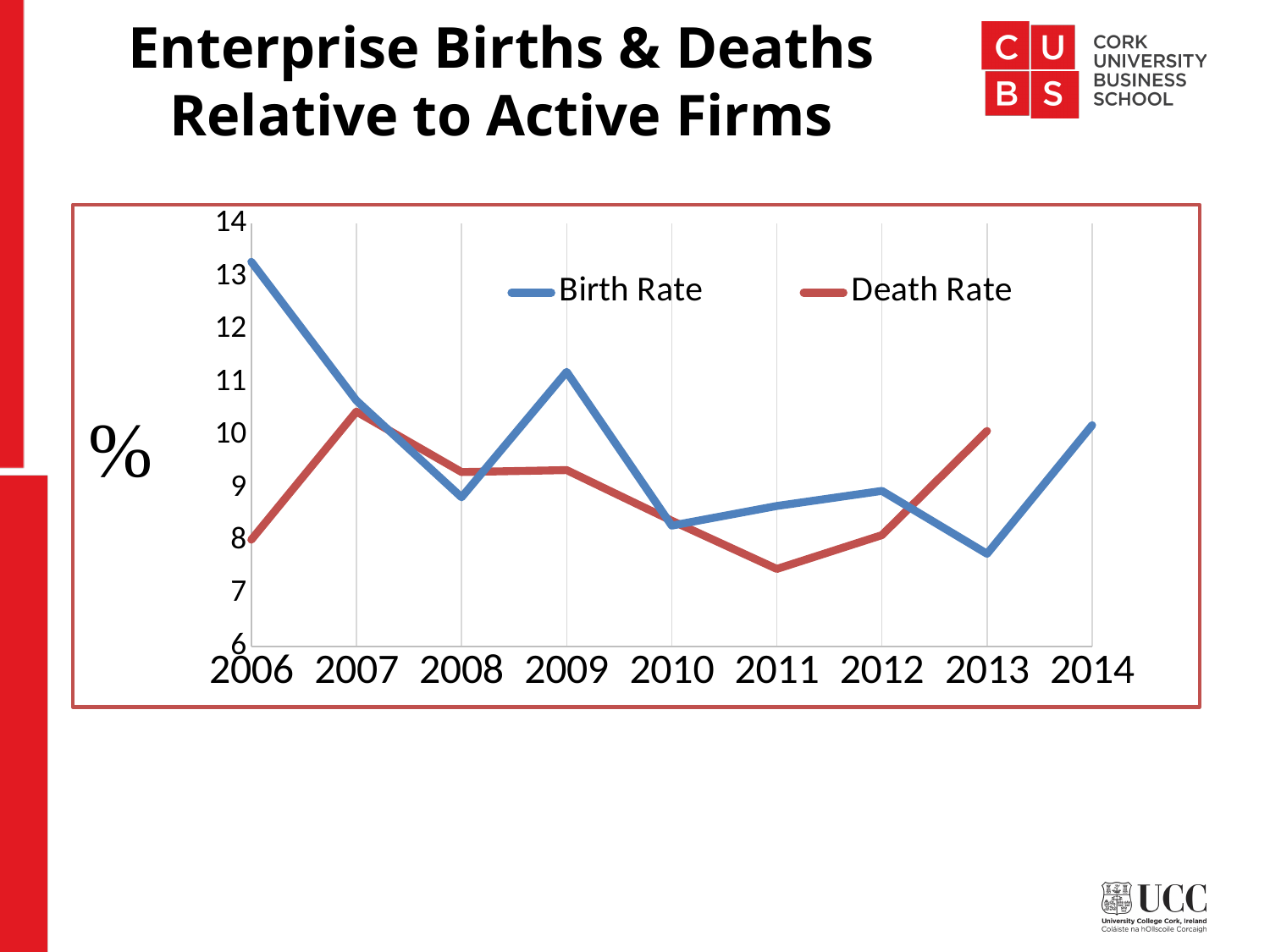
What kind of chart is shown on the slide? line chart In which year is the Death Rate highest? 2007 How many series does the legend list? 2 In which year is the Birth Rate highest? 2006 How many years are shown along the x axis? 9 In which year is the Death Rate lowest? 2011 Is the Death Rate in 2011 greater or less than 8? less In 2009, which is larger, the Birth Rate or the Death Rate? Birth Rate Is the Birth Rate in 2006 greater or less than 12? greater Does the Birth Rate rise or fall from 2006 to 2008? fall In which year is the Birth Rate lowest? 2013 In 2013, which is larger, the Birth Rate or the Death Rate? Death Rate